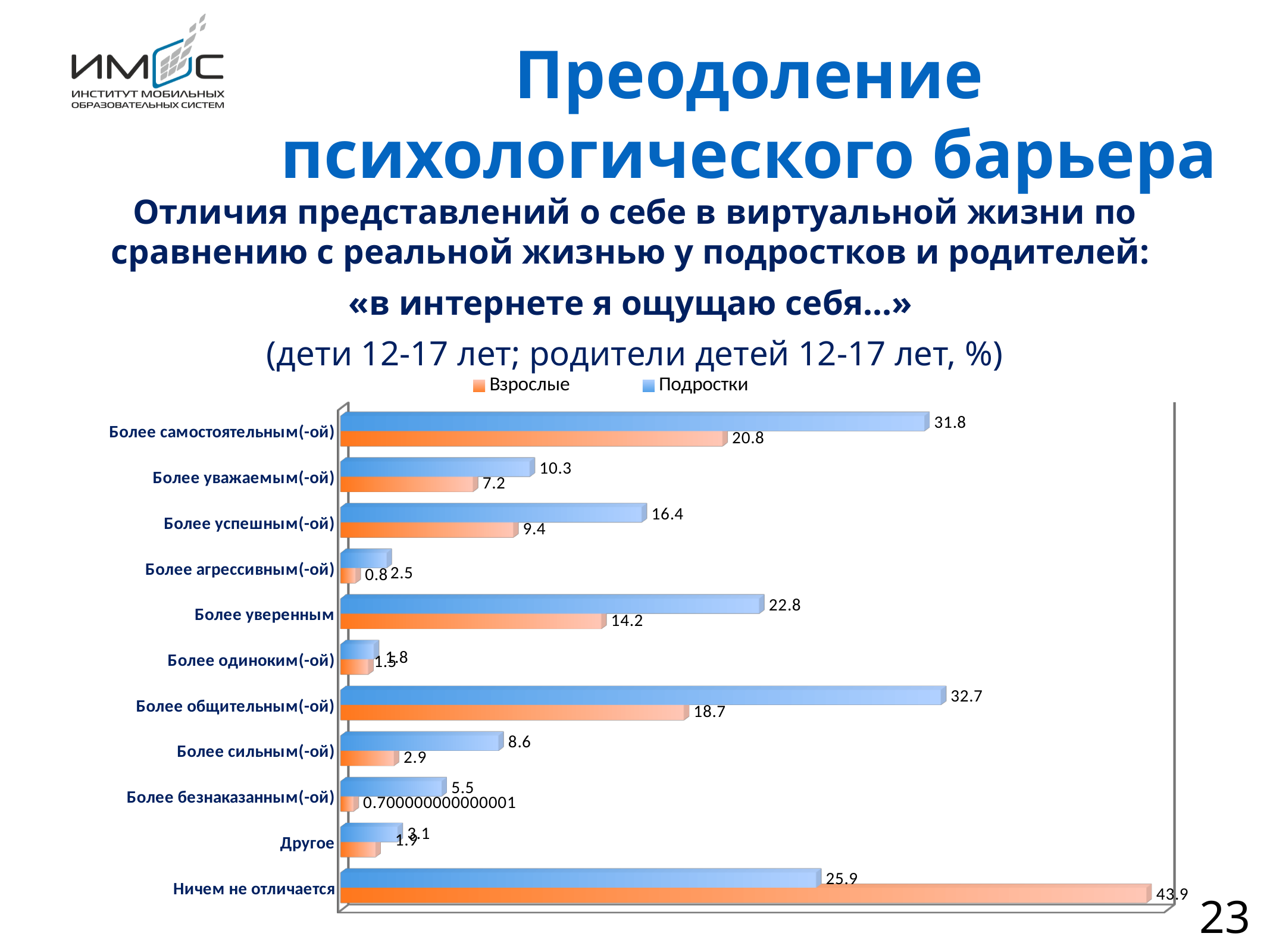
Which colour represents the Взрослые series in the chart? orange What is the value for Подростки in the category Более самостоятельным(-ой)? 31.8 What is the value for Взрослые in the category Ничем не отличается? 43.9 Which category has the highest value for Подростки? Более общительным(-ой) Which category has the highest value for Взрослые? Ничем не отличается Which is larger in the category Ничем не отличается: the value for Взрослые or for Подростки? Взрослые What is the value for Подростки in the category Более сильным(-ой)? 8.6 What is the difference between the Подростки and Взрослые values for Более общительным(-ой)? 14.0 What type of chart is shown on the slide? bar chart How many series does the chart legend list? 2 What is the value for Взрослые in the category Более уверенным? 14.2 How many categories are shown on the chart? 11